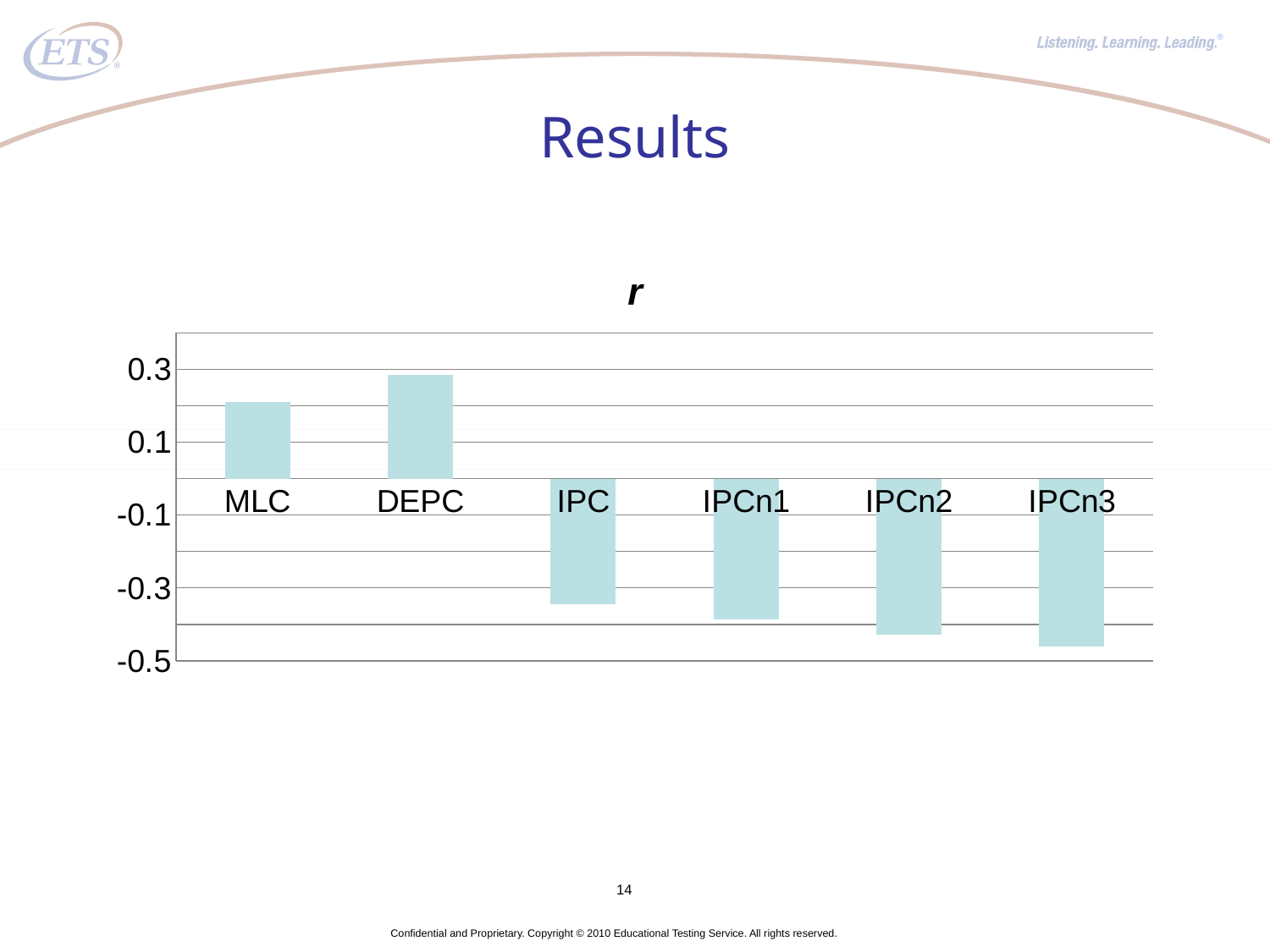
Which is larger, the value for MLC or the value for DEPC? DEPC What kind of chart is shown on the slide? bar chart What is the title of the chart? r Is the value for DEPC greater or less than 0.3? less How many categories are plotted in the chart? 6 Is the value for MLC greater or less than 0.1? greater Which is larger, the value for IPC or the value for IPCn3? IPC Is the value for IPC greater or less than -0.3? less Which category has the highest value in the chart? DEPC How many categories have negative values in the chart? 4 Do the values rise or fall across the categories from IPC to IPCn3? fall